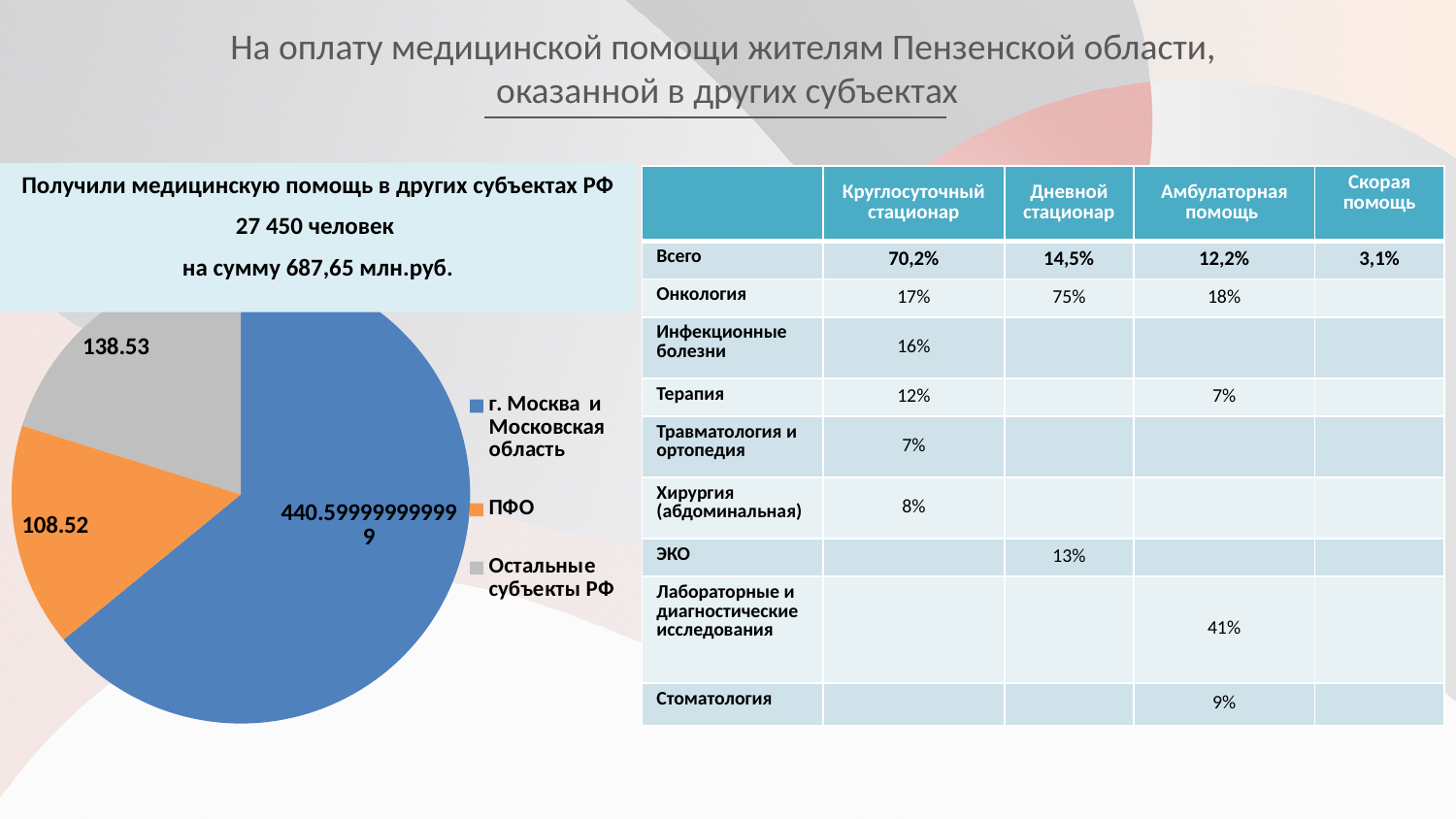
Which category has the smallest slice in the pie chart? ПФО Which category has the largest slice in the pie chart? г. Москва и Московская область What is the difference between the values for Остальные субъекты РФ and ПФО in the pie chart? 30.01 What colour is the slice for г. Москва и Московская область in the pie chart? blue How many entries does the legend of the pie chart list? 3 What colour is the ПФО slice in the pie chart? orange Which is larger in the pie chart: Остальные субъекты РФ or ПФО? Остальные субъекты РФ How many slices does the pie chart have? 3 What value is shown for ПФО in the pie chart? 108.52 What value is shown for Остальные субъекты РФ in the pie chart? 138.53 What kind of chart is shown on the left of the slide? pie chart What value is shown for г. Москва и Московская область in the pie chart? 440.599999999999